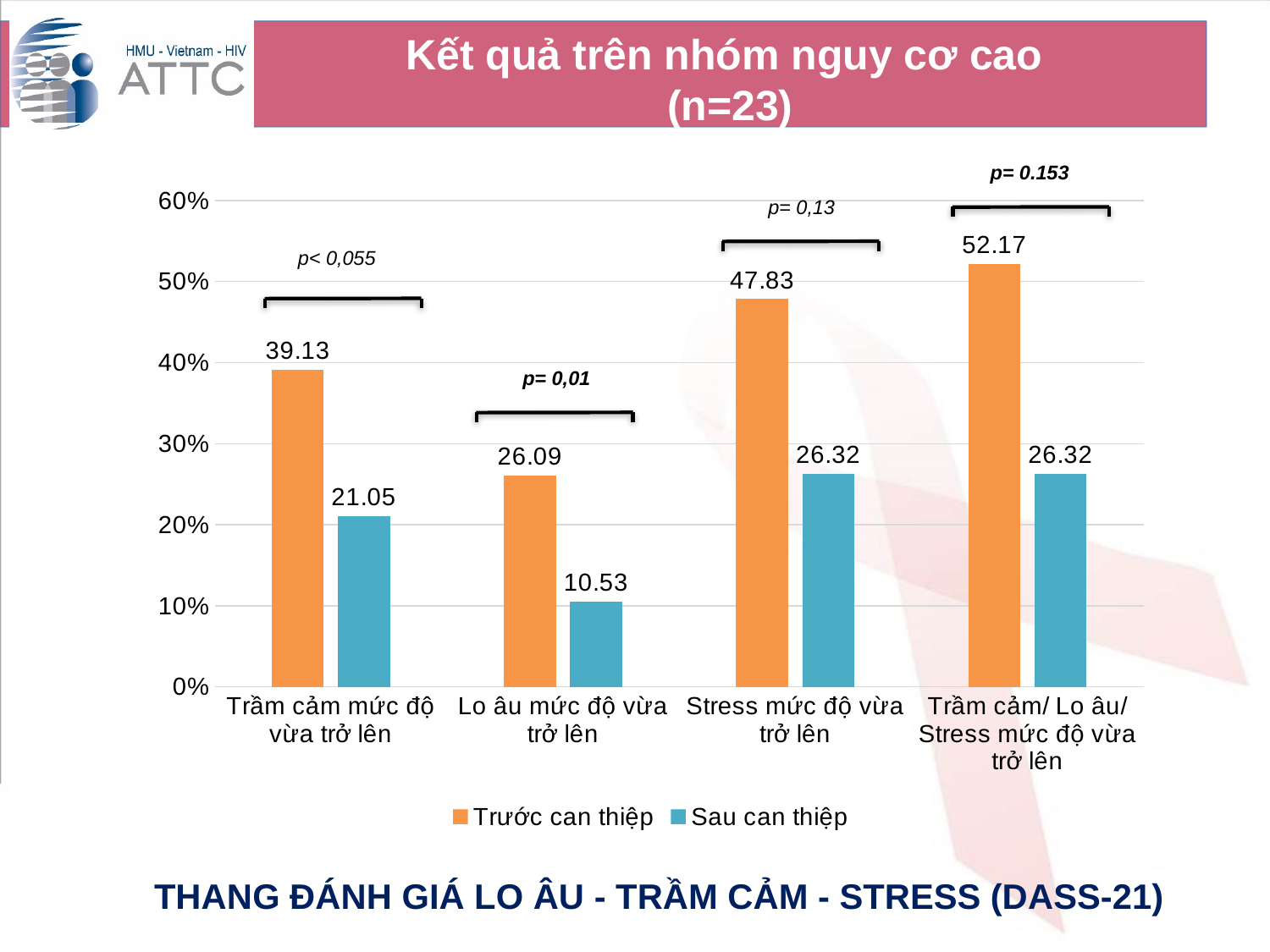
What is the difference between the "Trước can thiệp" and "Sau can thiệp" values for "Trầm cảm mức độ vừa trở lên"? 18.08 What kind of chart is shown on the slide? Bar chart Which category has the highest "Trước can thiệp" value? Trầm cảm/ Lo âu/ Stress mức độ vừa trở lên How many categories are shown on the x axis? 4 Which category has the lowest "Sau can thiệp" value? Lo âu mức độ vừa trở lên Is the "Trước can thiệp" value for "Stress mức độ vừa trở lên" greater or less than 40%? greater What is the value for "Sau can thiệp" in the category "Lo âu mức độ vừa trở lên"? 10.53 What p-value is shown above the "Lo âu mức độ vừa trở lên" category? p= 0,01 Which is larger: the "Trước can thiệp" value for "Lo âu mức độ vừa trở lên" or the "Sau can thiệp" value for "Stress mức độ vừa trở lên"? Sau can thiệp for Stress mức độ vừa trở lên (26.32) What is the value for "Sau can thiệp" in the category "Stress mức độ vừa trở lên"? 26.32 How many series does the legend list? 2 What is the value for "Trước can thiệp" in the category "Trầm cảm mức độ vừa trở lên"? 39.13